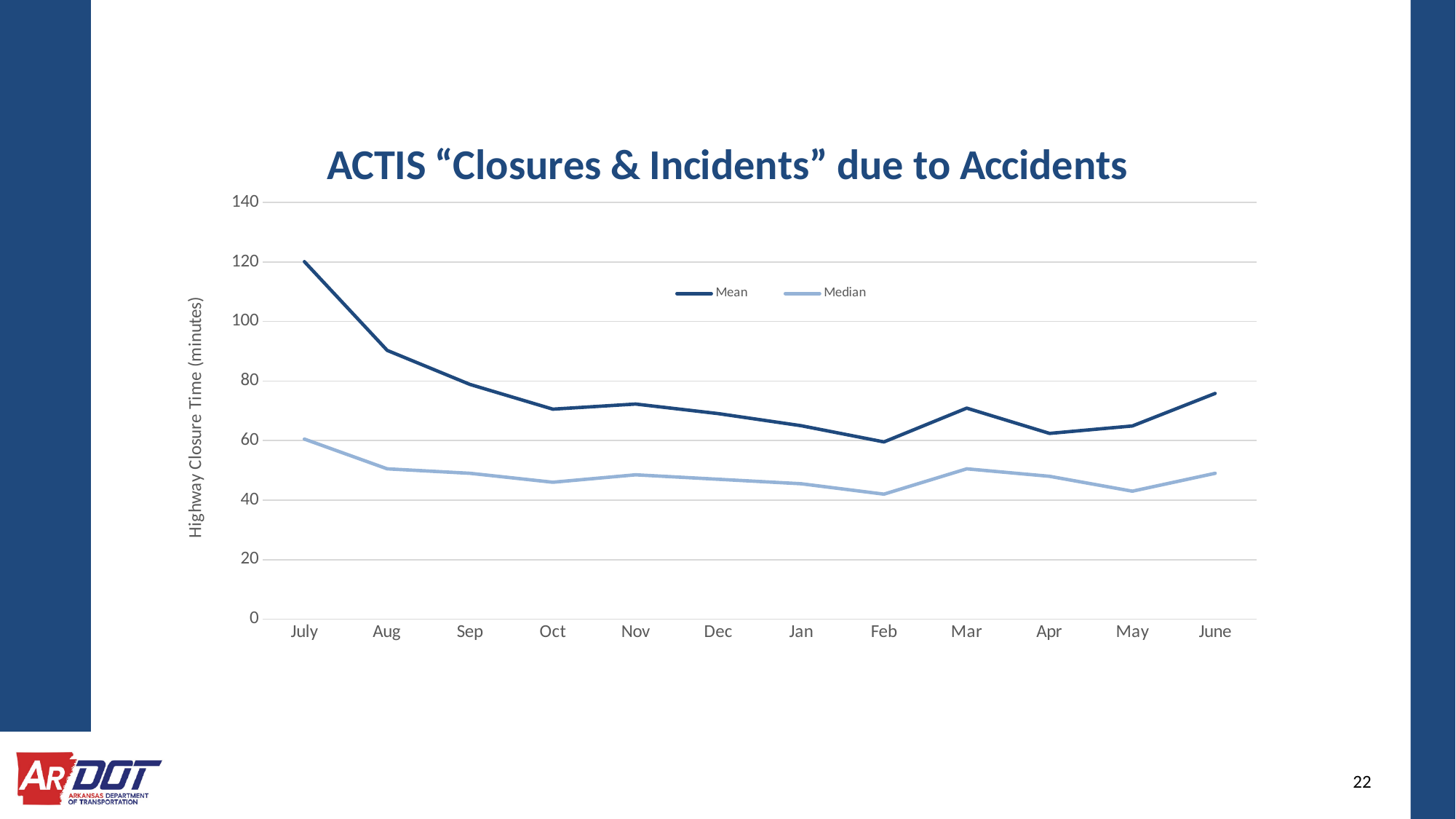
In which month is the Mean highway closure time highest? July Is the Mean value for July greater or less than 100? greater Is the Mean value for Feb greater or less than 80? less Which is larger in July, the Mean or the Median? Mean How many series does the legend list? 2 Is the Median value for Aug greater or less than 60? less How many months are plotted along the x axis? 12 In which month is the Mean highway closure time lowest? Feb What kind of chart is shown on the slide? line chart Does the Mean line rise or fall from July to Oct? fall In which month is the Median highway closure time highest? July What is the label on the vertical axis? Highway Closure Time (minutes)